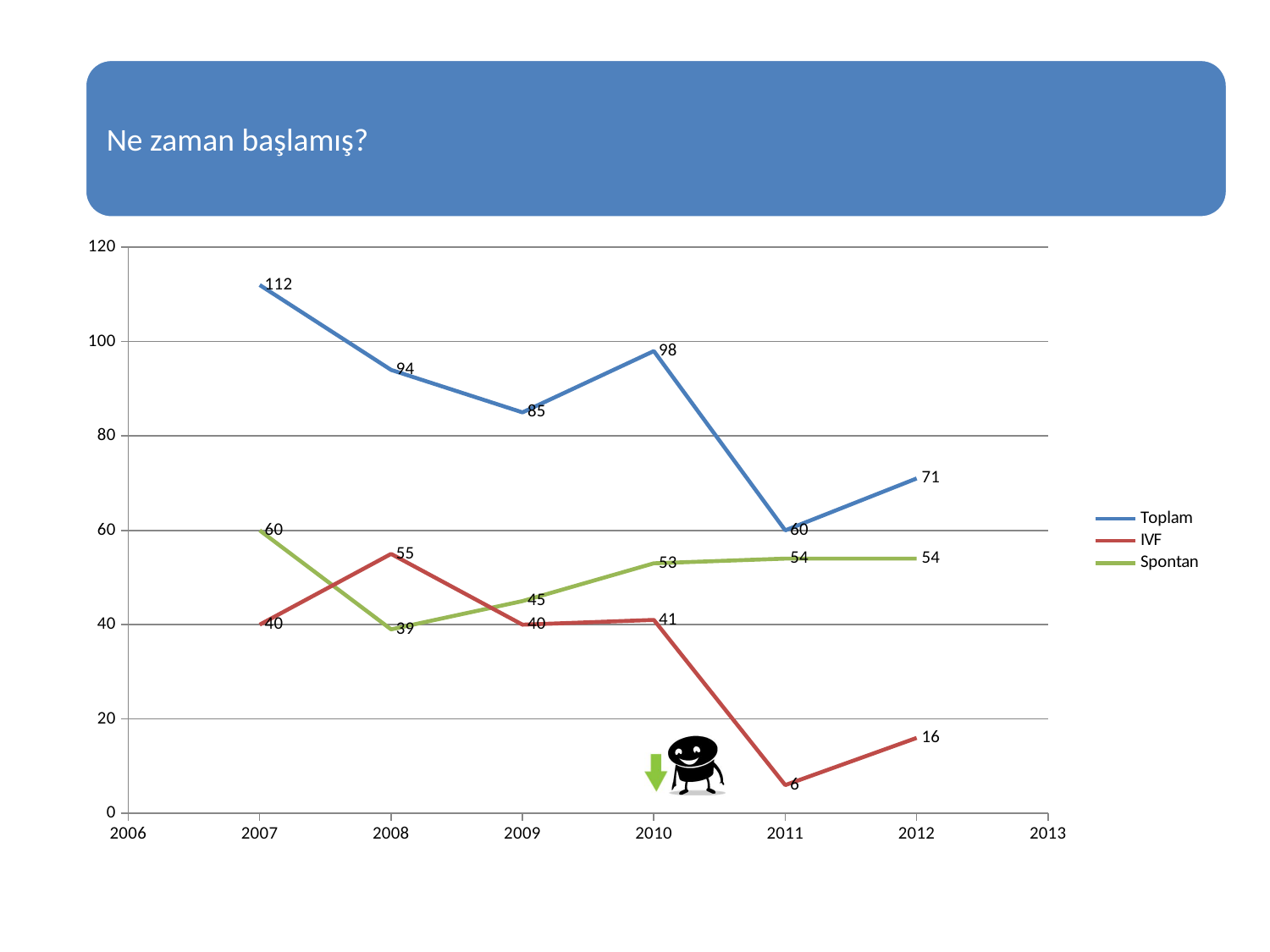
In which year is the Toplam series lowest? 2011 How many series does the legend list? 3 What kind of chart is shown on the slide? Line chart What is the Toplam value in 2007? 112 In which year is the IVF series highest? 2008 What is the Spontan value in 2010? 53 Which is larger in 2008, the IVF value or the Spontan value? IVF What is the difference between the Toplam values in 2007 and 2012? 41 What colour is the line for the IVF series? Red What is the IVF value in 2011? 6 Does the Spontan series rise or fall from 2008 to 2012? Rise How many years have data points plotted for the Toplam series? 6